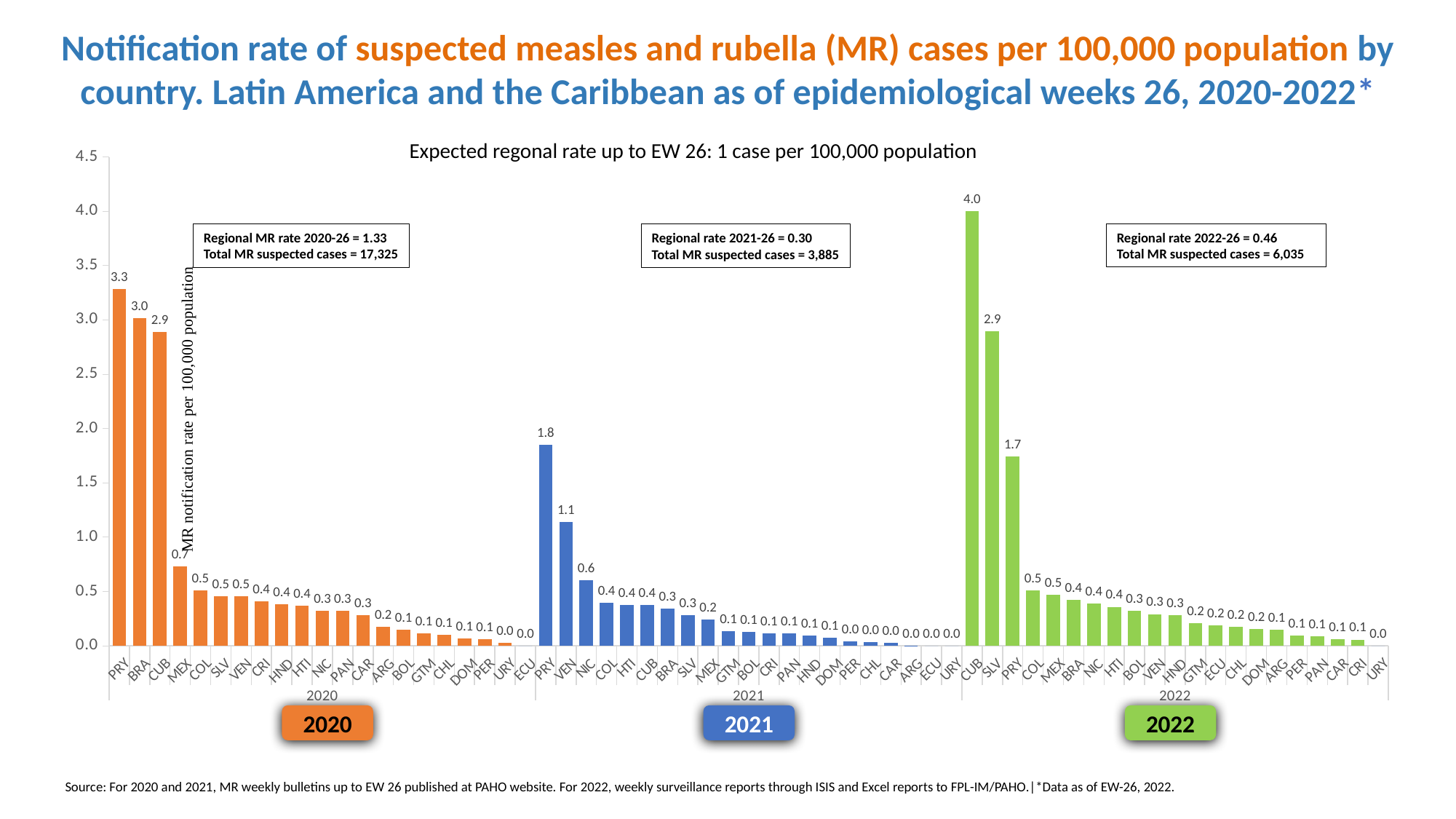
What is the notification rate for PRY in 2020? 3.3 How many countries are shown for the year 2021? 21 What is the notification rate for CUB in 2022? 4.0 Which country has the highest notification rate in 2022? CUB What is the notification rate for VEN in 2021? 1.1 What is the difference between the 2020 rates for PRY and BRA? 0.3 What is the difference between the 2022 rates for CUB and PRY? 2.3 What is the regional MR rate for 2020-26 stated in the text box? 1.33 What is the notification rate for SLV in 2022? 2.9 Which is larger, the rate for PRY in 2020 or the rate for PRY in 2021? PRY in 2020 What kind of chart is shown on the slide? Bar chart Which country has the highest notification rate in 2021? PRY